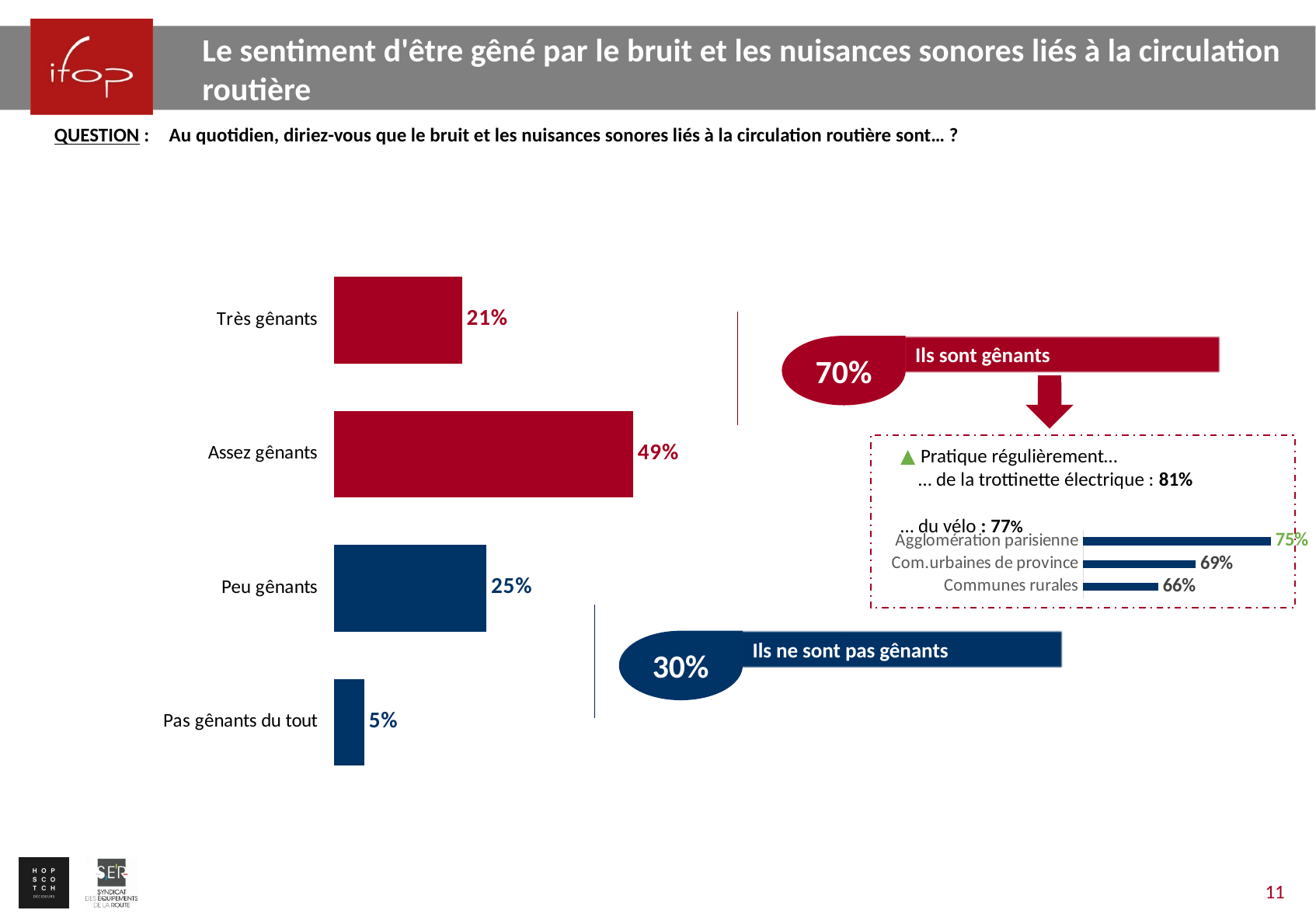
In the small bar chart inside the dashed box on the right, which category has the highest value? Agglomération parisienne In the large bar chart on the left, which category has the highest value? Assez gênants In the large bar chart on the left, which is larger: "Peu gênants" or "Très gênants"? Peu gênants What kind of chart is the large chart on the left? Bar chart In the large bar chart on the left, what is the value for "Pas gênants du tout"? 5% In the large bar chart on the left, what is the value for "Assez gênants"? 49% In the large bar chart on the left, which category has the lowest value? Pas gênants du tout How many categories does the large bar chart on the left show? 4 In the small bar chart inside the dashed box on the right, what is the value for "Communes rurales"? 66% In the small bar chart inside the dashed box on the right, what is the difference between "Agglomération parisienne" and "Com.urbaines de province"? 6 percentage points In the large bar chart on the left, what colour are the bars for "Peu gênants" and "Pas gênants du tout"? Dark blue In the large bar chart on the left, what is the difference between "Assez gênants" and "Très gênants"? 28 percentage points